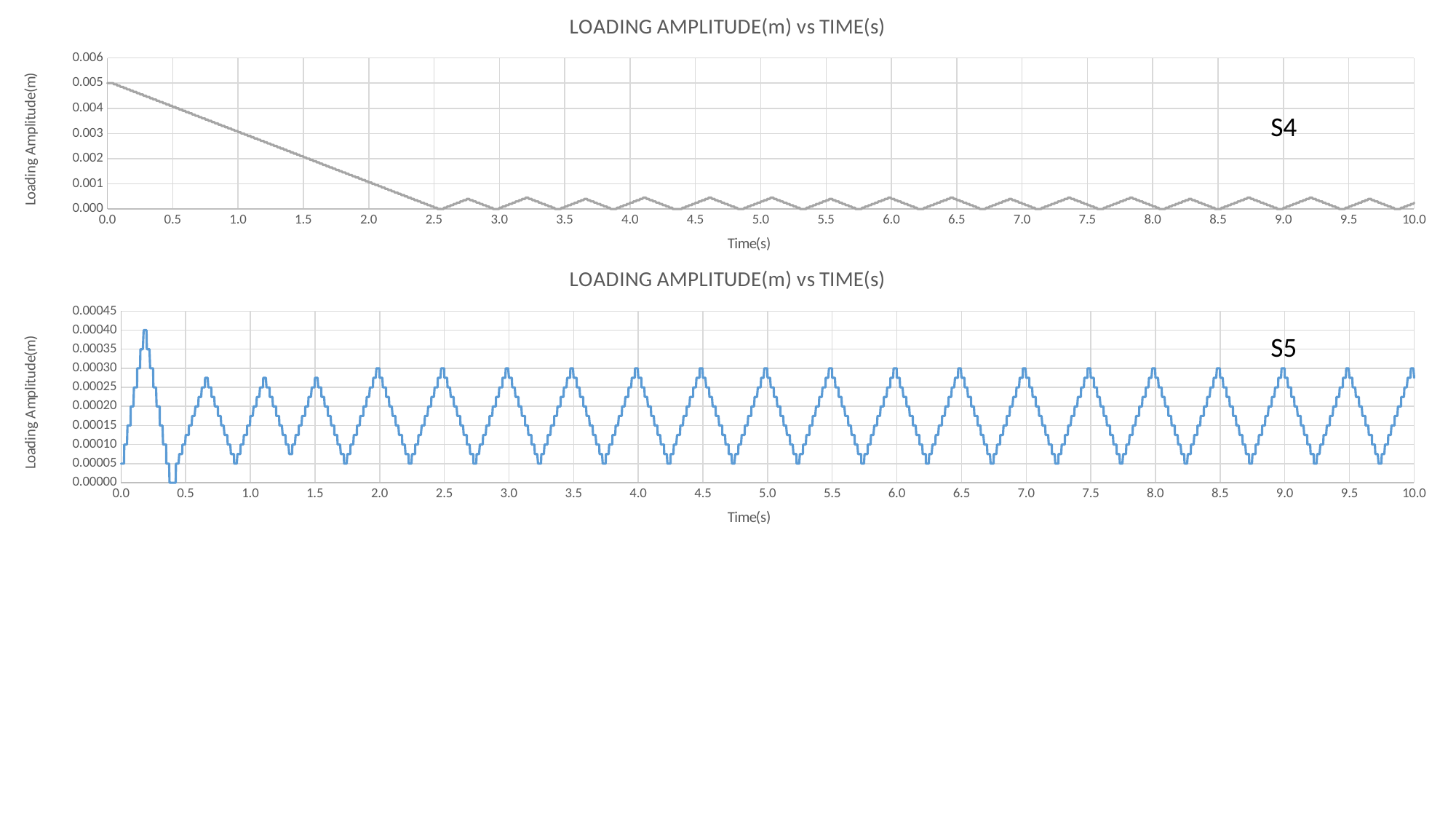
In the bottom chart (S5), is the peak loading amplitude at 5.0 s greater or less than 0.00035? less In the bottom chart (S5), what is the highest loading amplitude reached by the line? 0.00040 What type of chart is the top chart labelled S4? line chart What is the title of the top chart? LOADING AMPLITUDE(m) vs TIME(s) What type of chart is the bottom chart labelled S5? line chart In the bottom chart (S5), is the loading amplitude at 0.2 s greater or less than 0.00035? greater Which chart has the larger starting loading amplitude at time 0.0 s, the top chart (S4) or the bottom chart (S5)? top chart (S4) In the top chart (S4), what is the loading amplitude at time 0.0 s? 0.005 In the top chart (S4), does the loading amplitude rise or fall between 0.0 s and 2.5 s? fall In the top chart (S4), is the loading amplitude at 1.0 s greater or less than 0.002? greater What is the x-axis label of the bottom chart (S5)? Time(s)